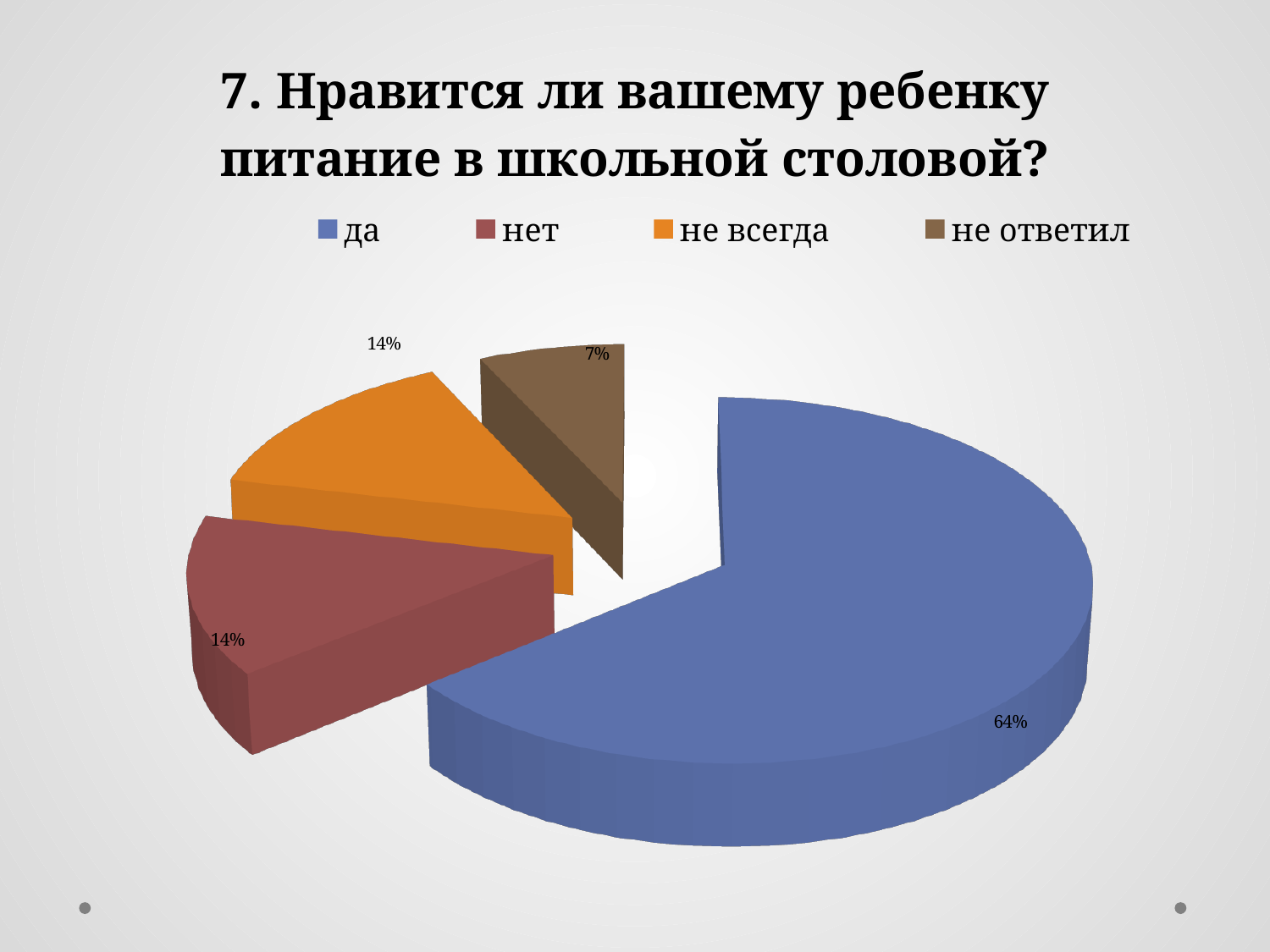
What type of chart is shown on the slide? pie chart What share of the pie does "да" have? 64% What share of the pie does "нет" have? 14% What share of the pie does "не ответил" have? 7% What colour is the slice for "не всегда"? orange What is the difference between the shares for "не всегда" and "не ответил"? 7% Which category has the largest slice of the pie? да Which is larger, the share for "да" or the share for "не ответил"? да Which category has the smallest slice of the pie? не ответил What share of the pie does "не всегда" have? 14% How many categories does the legend list? 4 What is the difference between the shares for "да" and "нет"? 50%